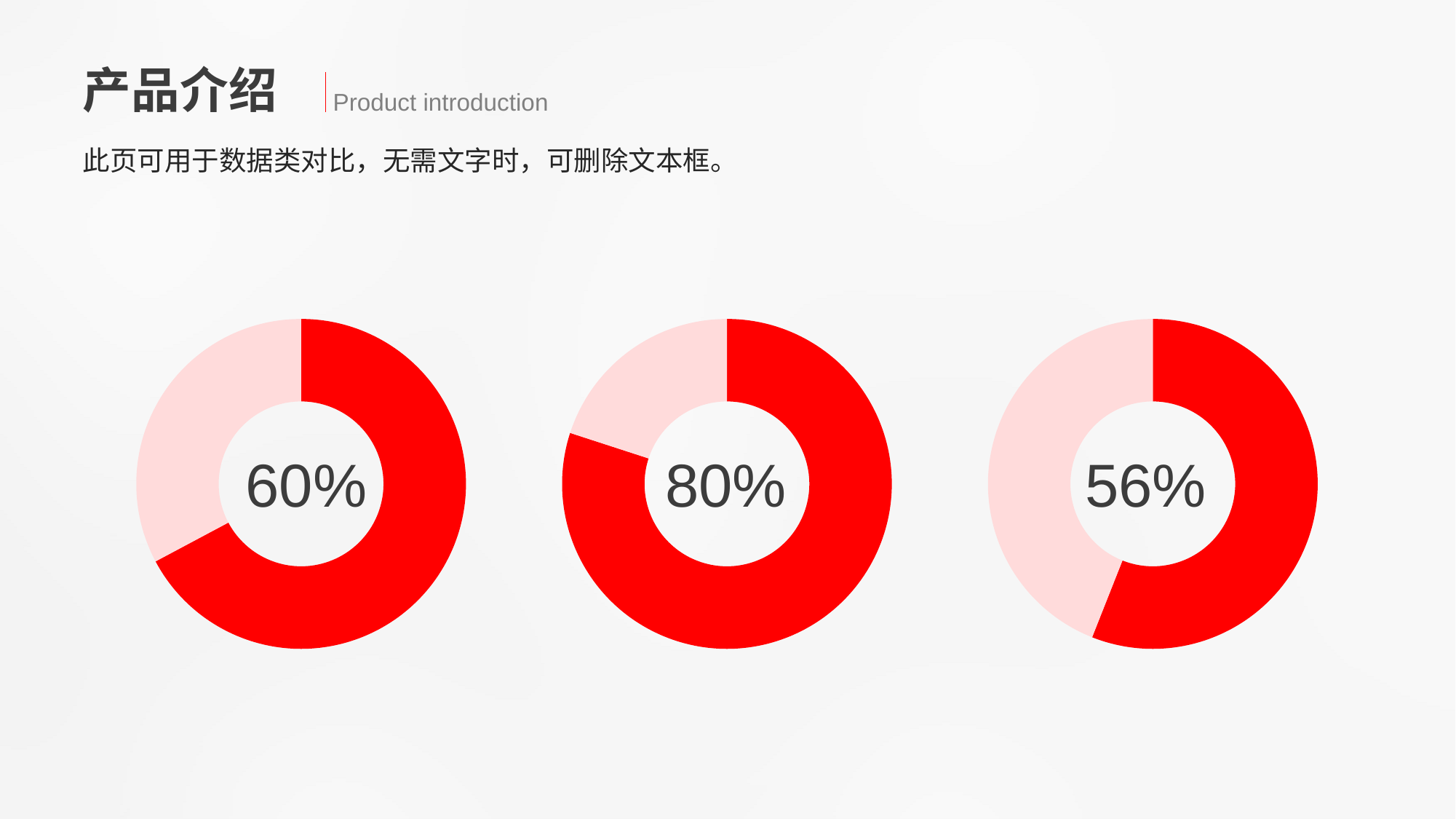
What is the difference between the percentage in the left doughnut chart and the percentage in the right doughnut chart? 4% Which of the three doughnut charts shows the highest percentage: left, middle or right? middle What percentage is shown in the centre of the left doughnut chart? 60% What colour is the filled (highlighted) segment in each doughnut chart? red What percentage is shown in the centre of the middle doughnut chart? 80% What kind of chart is used on this slide? doughnut chart What percentage is shown in the centre of the right doughnut chart? 56% How many doughnut charts are on the slide? 3 Which of the three doughnut charts shows the lowest percentage: left, middle or right? right In the right doughnut chart, what share of the ring is filled by the dark red segment? 56% What is the difference between the percentage in the middle doughnut chart and the percentage in the left doughnut chart? 20% Which is larger, the percentage in the left doughnut chart or the percentage in the right doughnut chart? left